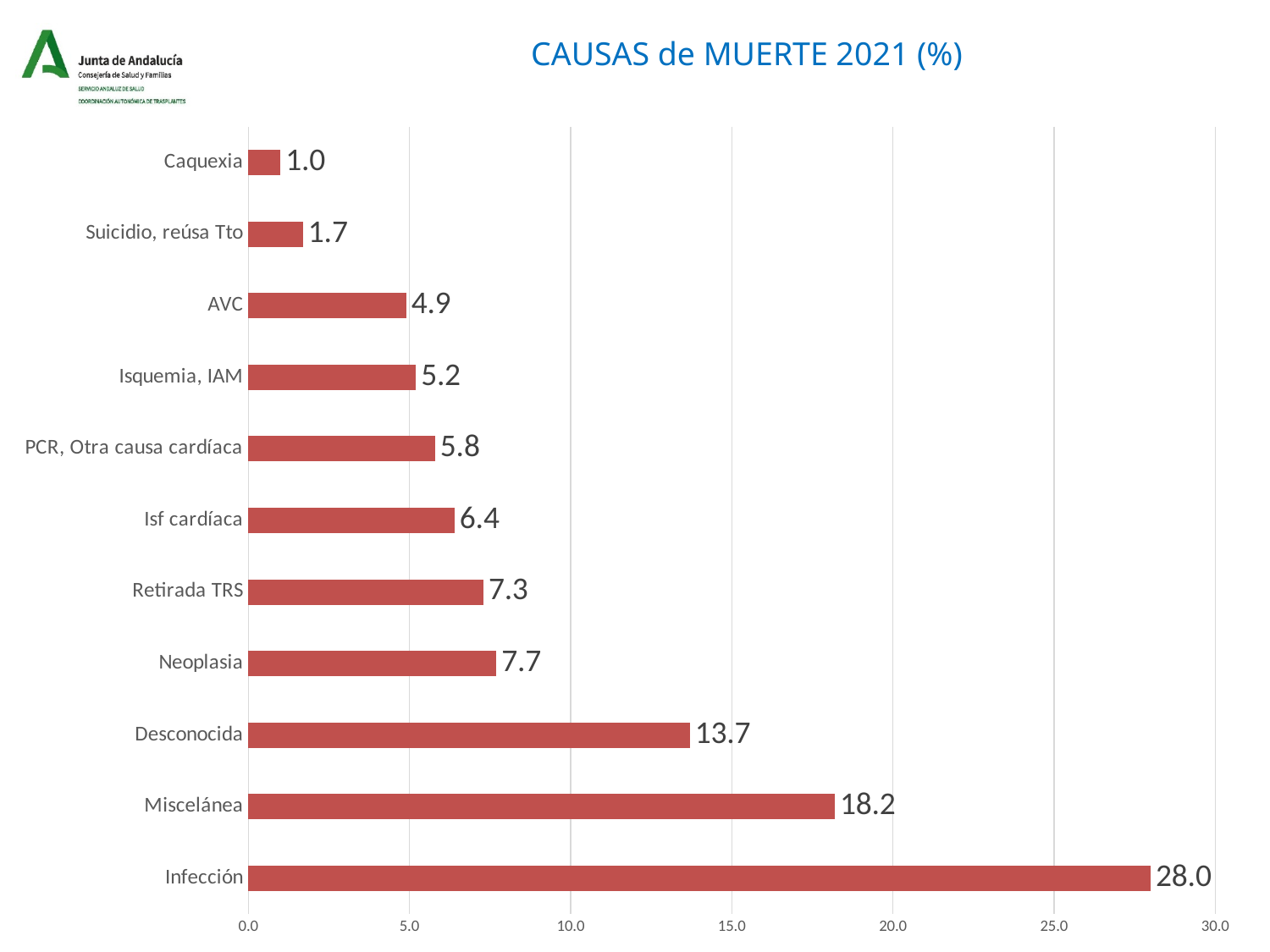
Which is larger, the value for AVC or the value for Isquemia, IAM? Isquemia, IAM Which cause of death has the highest value? Infección What is the value for Retirada TRS? 7.3 How many categories are shown in the chart? 11 What is the value for Infección? 28.0 What is the difference between the values for Neoplasia and Isf cardíaca? 1.3 What is the title of the chart? CAUSAS de MUERTE 2021 (%) Is the value for Desconocida greater or less than 15.0? less What kind of chart is shown on the slide? bar chart What is the value for Desconocida? 13.7 What is the difference between the values for Infección and Miscelánea? 9.8 Which cause of death has the lowest value? Caquexia